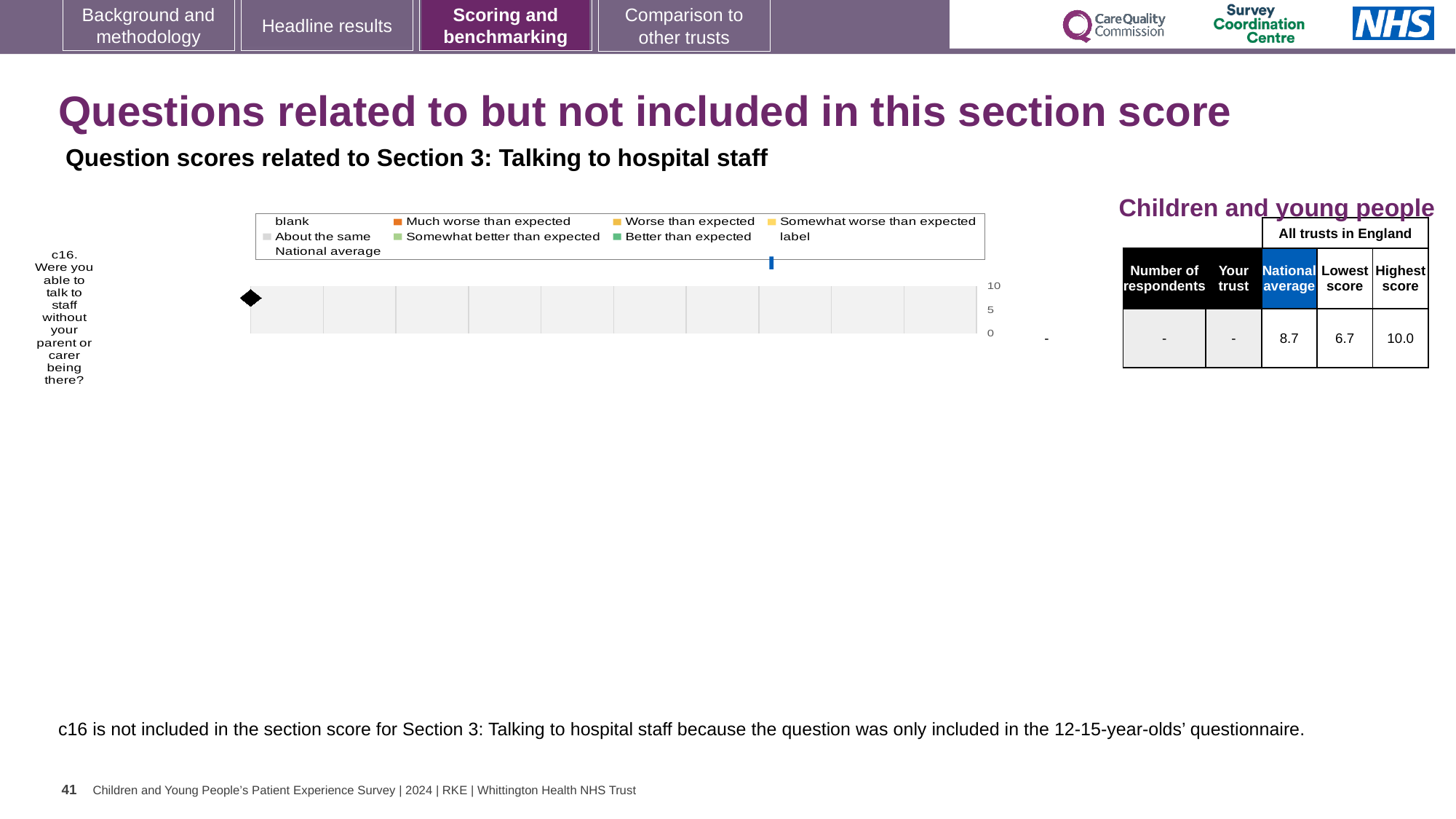
Is the national average for c16 greater or less than 5? greater How many questions (categories) are plotted on the chart? 1 What is the highest score across all trusts in England for c16 shown in the table? 10.0 What is the national average score for c16 shown in the table next to the chart? 8.7 Which question is shown on the chart's category axis? c16. Were you able to talk to staff without your parent or carer being there? What is the lowest score across all trusts in England for c16 shown in the table? 6.7 What is the difference between the highest score and the lowest score for c16 in the table? 3.3 What kind of chart is shown on the slide? bar chart What is the highest value shown on the chart's value axis? 10